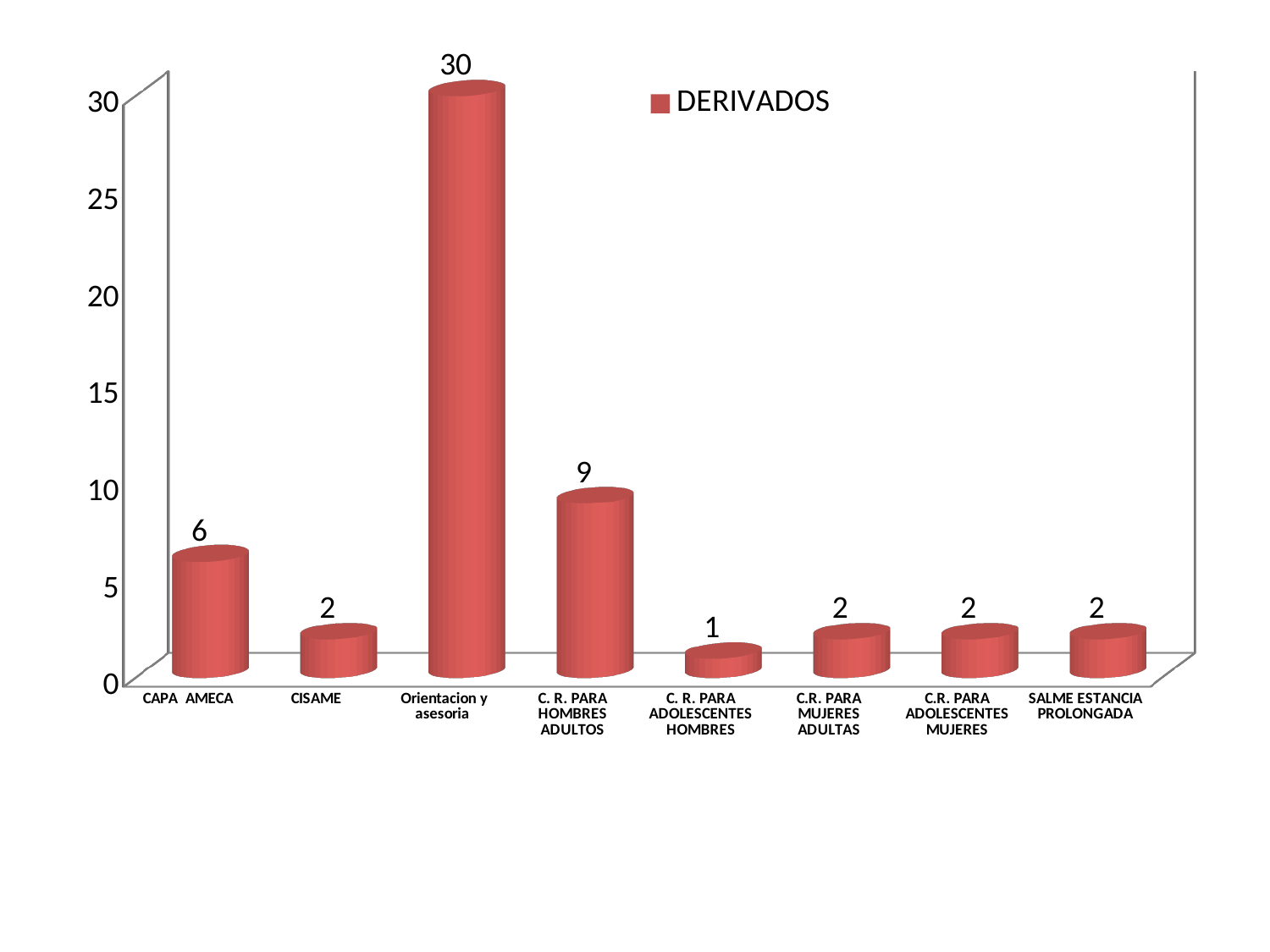
What kind of chart is shown on the slide? Bar chart What is the value for CAPA AMECA? 6 How many categories are shown on the x axis? 8 What is the difference between the values for Orientacion y asesoria and C. R. PARA HOMBRES ADULTOS? 21 What is the value for C. R. PARA ADOLESCENTES HOMBRES? 1 What is the value for C. R. PARA HOMBRES ADULTOS? 9 What is the name of the series shown in the legend? DERIVADOS How many series does the legend list? 1 What is the value for Orientacion y asesoria? 30 Which category has the highest value? Orientacion y asesoria Which category has the lowest value? C. R. PARA ADOLESCENTES HOMBRES Which is larger, the value for CAPA AMECA or the value for CISAME? CAPA AMECA